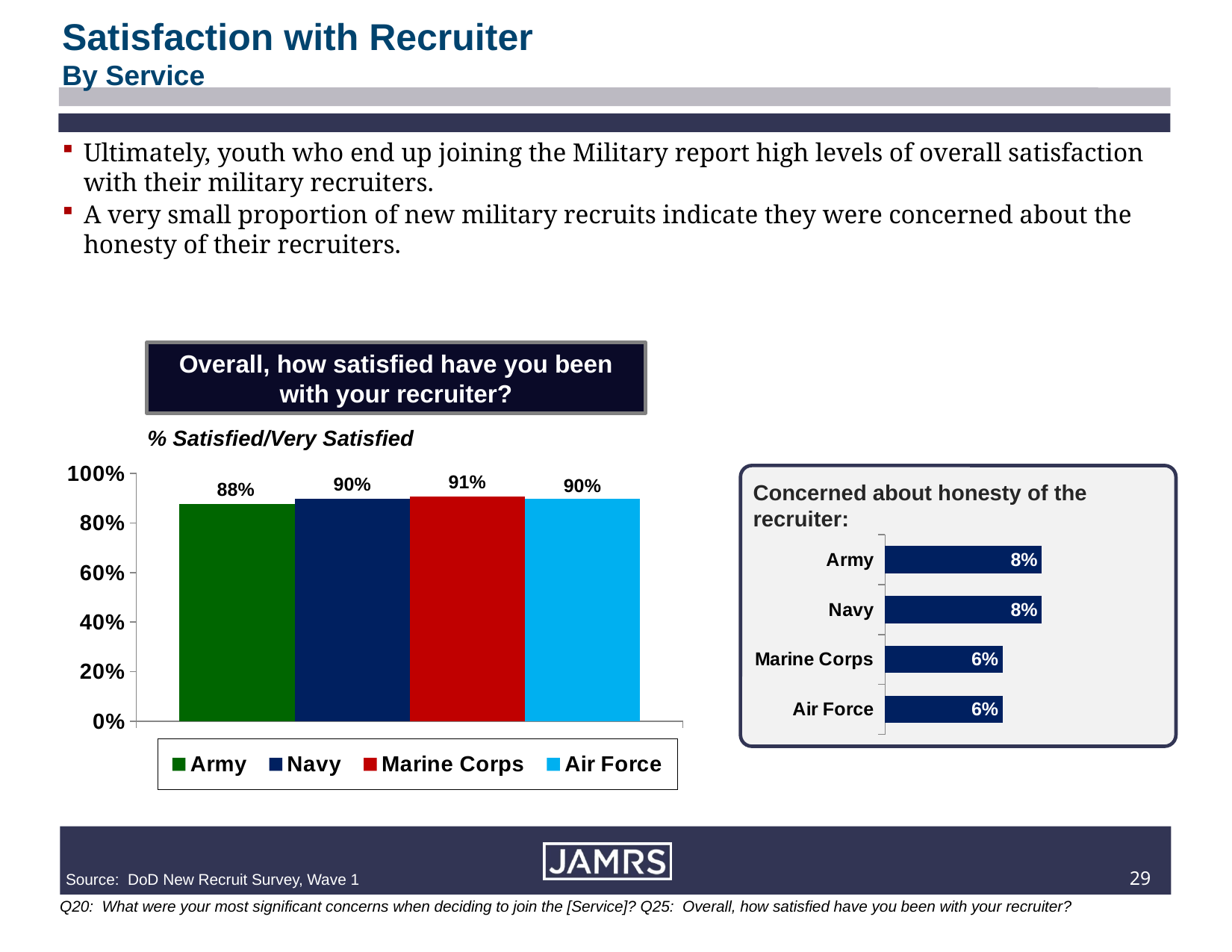
In the satisfaction chart, what is the difference between the Marine Corps and Army values? 3% In the 'Concerned about honesty of the recruiter' chart, what is the value for Air Force? 6% In the satisfaction chart, which service has the highest percentage satisfied/very satisfied? Marine Corps In the 'Concerned about honesty of the recruiter' chart, which is larger, the value for Army or the value for Marine Corps? Army In the satisfaction chart, what percentage of Army recruits were satisfied or very satisfied with their recruiter? 88% In the satisfaction chart, how many services are shown? 4 In the satisfaction chart, how many entries does the legend list? 4 In the satisfaction chart, which service has the lowest percentage satisfied/very satisfied? Army In the 'Concerned about honesty of the recruiter' chart, what is the value for Navy? 8% What type of chart is the satisfaction chart on the left? Bar chart In the satisfaction chart, what is the value for Marine Corps? 91% In the satisfaction chart, what colour is the Marine Corps bar? Red